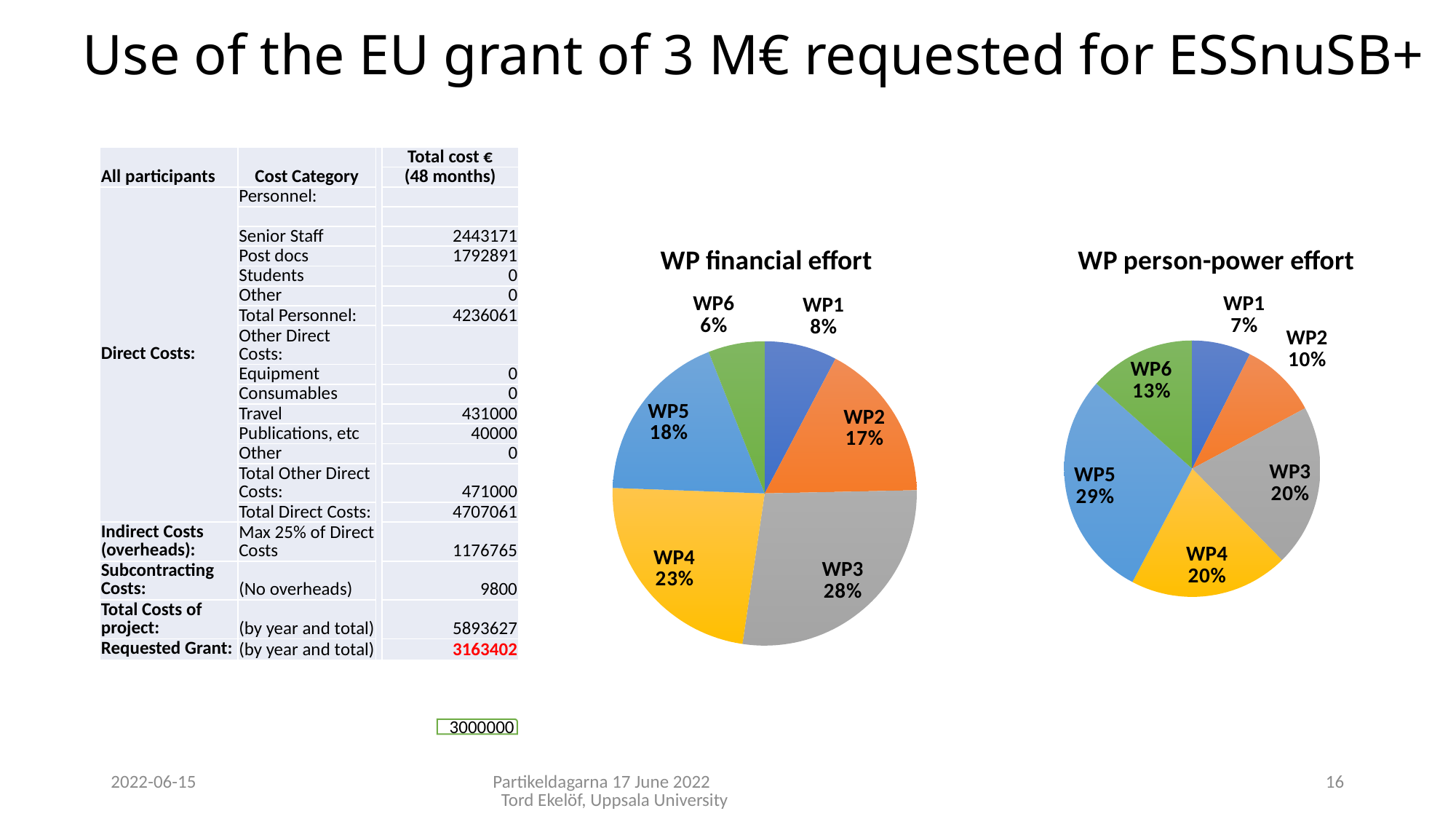
In the 'WP person-power effort' chart, which work package has the smallest share? WP1 In the 'WP financial effort' chart, which work package has the largest share? WP3 What colour is the WP3 slice in the 'WP person-power effort' chart? Grey How many slices does the 'WP financial effort' pie chart have? 6 In the 'WP person-power effort' chart, which is larger, the share of WP6 or the share of WP2? WP6 In the 'WP person-power effort' chart, which work package has the largest share? WP5 What type of chart is 'WP person-power effort'? Pie chart In the 'WP person-power effort' chart, what share does WP5 have? 29% In the 'WP financial effort' chart, which work package has the smallest share? WP6 In the 'WP financial effort' chart, what is the difference in percentage points between WP4 and WP5? 5 In the 'WP financial effort' chart, what share does WP2 have? 17% In the 'WP financial effort' chart, what share does WP3 have? 28%